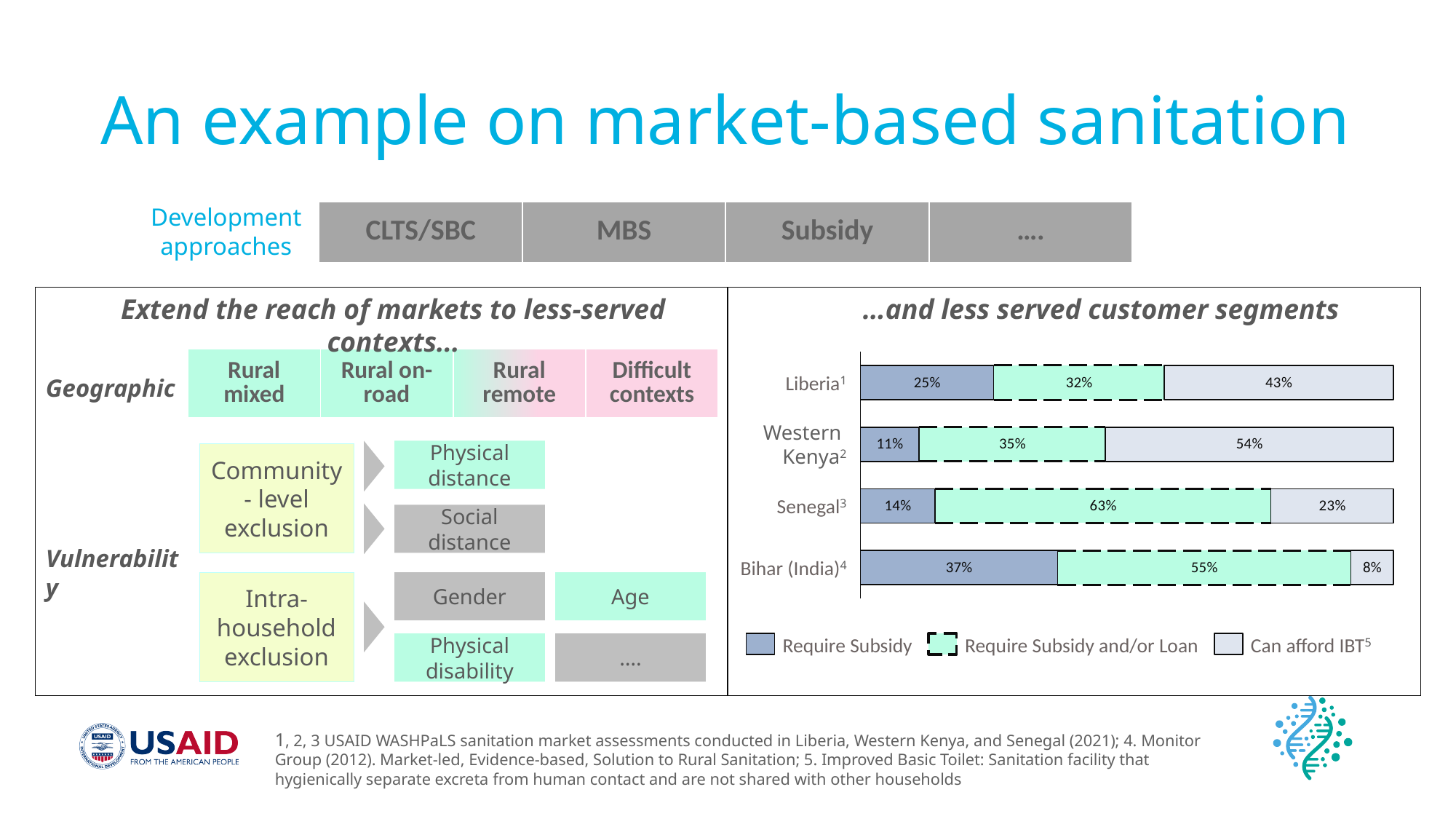
What is the difference between the 'Can afford IBT' values for Western Kenya and Senegal? 31% Which is larger: the 'Require Subsidy and/or Loan' share for Liberia or for Western Kenya? Western Kenya What type of chart is shown on the right side of the slide? Stacked bar chart Which country or region has the lowest 'Can afford IBT' share? Bihar (India) Which country or region has the highest 'Require Subsidy' share? Bihar (India) What is the 'Can afford IBT' value for Western Kenya? 54% How many series does the legend list? 3 What percentage of households in Liberia require a subsidy? 25% What is the 'Require Subsidy and/or Loan' value for Senegal? 63% How many countries or regions are shown in the chart? 4 Which legend entry is drawn with a dashed outline? Require Subsidy and/or Loan What is the 'Can afford IBT' value for Bihar (India)? 8%